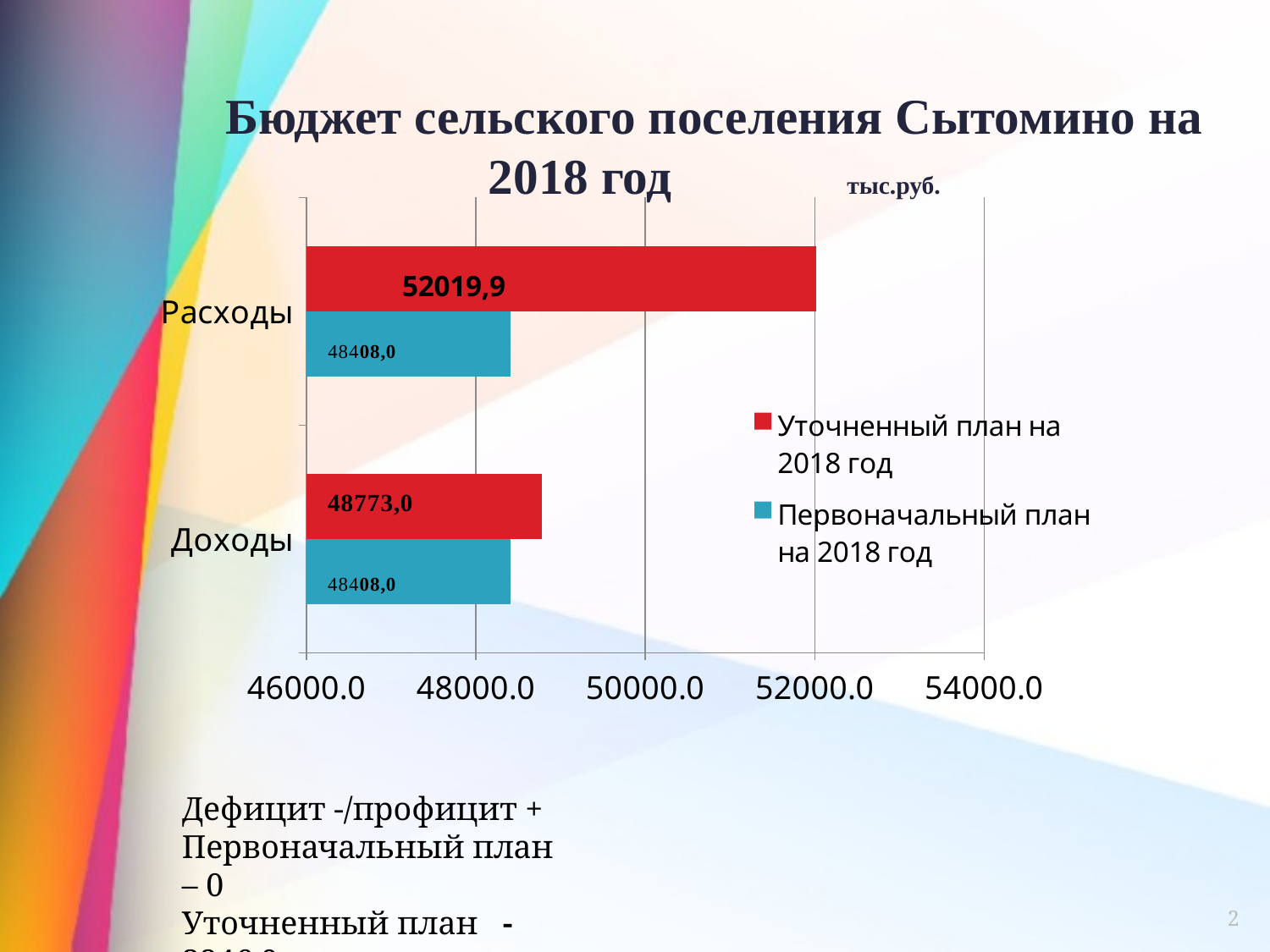
Which category has the highest value for Уточненный план на 2018 год? Расходы What is the value of Уточненный план на 2018 год for Расходы? 52019,9 How many series does the legend list? 2 What is the value of Первоначальный план на 2018 год for Расходы? 48408,0 What is the value of Уточненный план на 2018 год for Доходы? 48773,0 Which is larger: Уточненный план на 2018 год for Доходы or Первоначальный план на 2018 год for Доходы? Уточненный план на 2018 год What is the value of Первоначальный план на 2018 год for Доходы? 48408,0 What is the difference between Уточненный план на 2018 год for Расходы and for Доходы? 3246,9 What kind of chart is shown on the slide? bar chart Is the value of Уточненный план на 2018 год for Расходы greater or less than 50000.0? greater How many categories are shown on the chart? 2 What is the difference between Уточненный план на 2018 год and Первоначальный план на 2018 год for Расходы? 3611,9